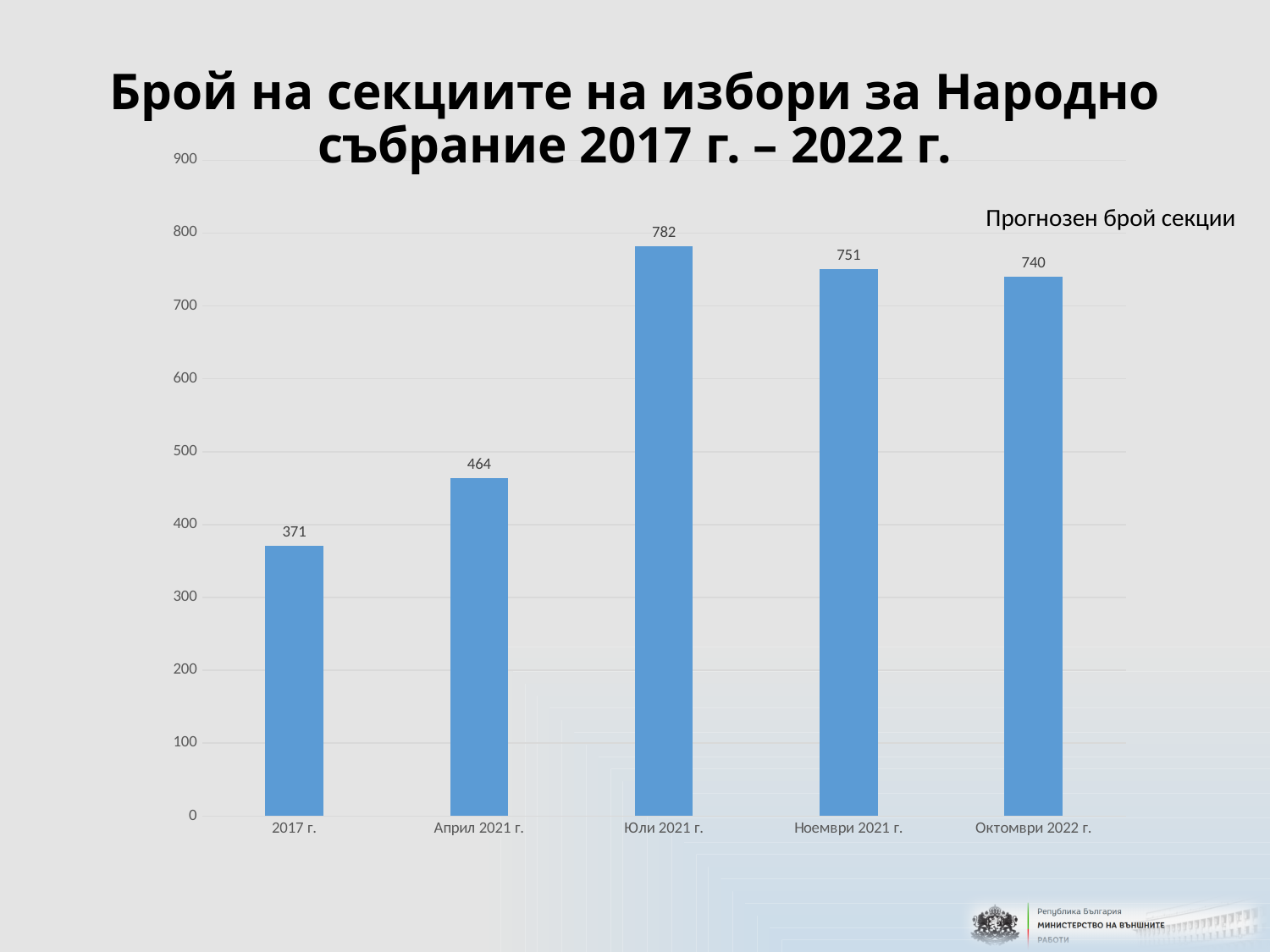
What is the title of the chart? Брой на секциите на избори за Народно събрание 2017 г. – 2022 г. Which is larger, the value for Ноември 2021 г. or Октомври 2022 г.? Ноември 2021 г. What kind of chart is shown on the slide? bar chart Which category has the highest value? Юли 2021 г. Is the value for Април 2021 г. greater or less than 500? less What is the value for Юли 2021 г.? 782 What is the value for 2017 г.? 371 Which category has the lowest value? 2017 г. What is the difference between the values for Юли 2021 г. and Ноември 2021 г.? 31 How many categories are shown on the x axis? 5 What is the difference between the values for Април 2021 г. and 2017 г.? 93 What is the value for Октомври 2022 г.? 740